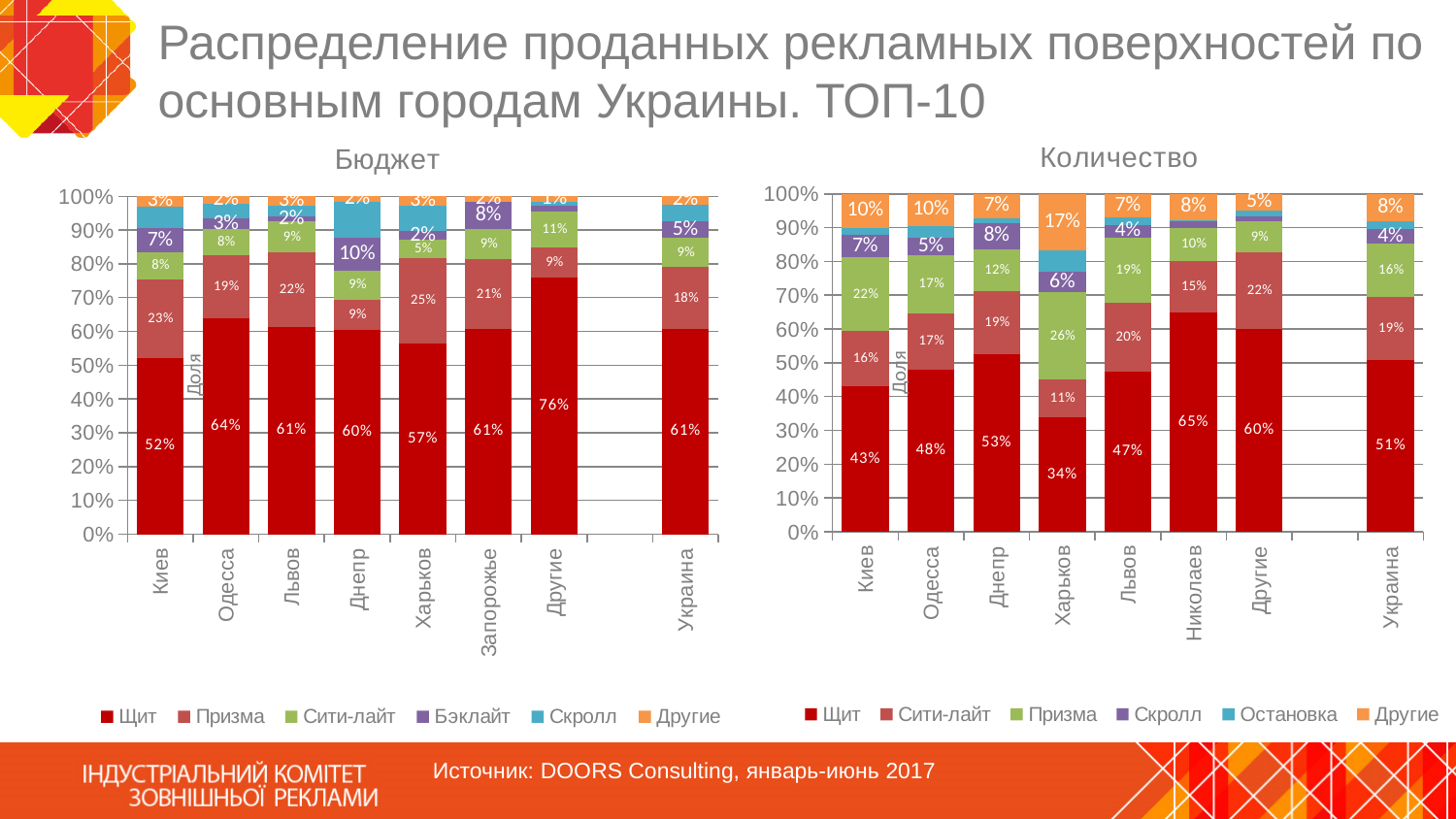
On the "Бюджет" chart, what is the value for Щит in Киев? 52% On the "Количество" chart, what is the value for Щит in Харьков? 34% On the "Бюджет" chart, which category has the highest Щит share? Другие On the "Количество" chart, which category has the lowest Щит share? Харьков On the "Количество" chart, what is the value for Сити-лайт in Украина? 19% What kind of chart is the "Количество" chart? Stacked bar chart On the "Бюджет" chart, what is the value for Призма in Харьков? 25% On the "Бюджет" chart, how many series does the legend list? 6 On the "Количество" chart, how many categories are shown on the x axis? 8 On the "Количество" chart, what is the difference between the Щит share in Николаев and in Другие? 5% On the "Количество" chart, which is larger: the Призма share in Киев or in Одесса? Киев On the "Бюджет" chart, what is the difference between the Щит share in Одесса and in Киев? 12%